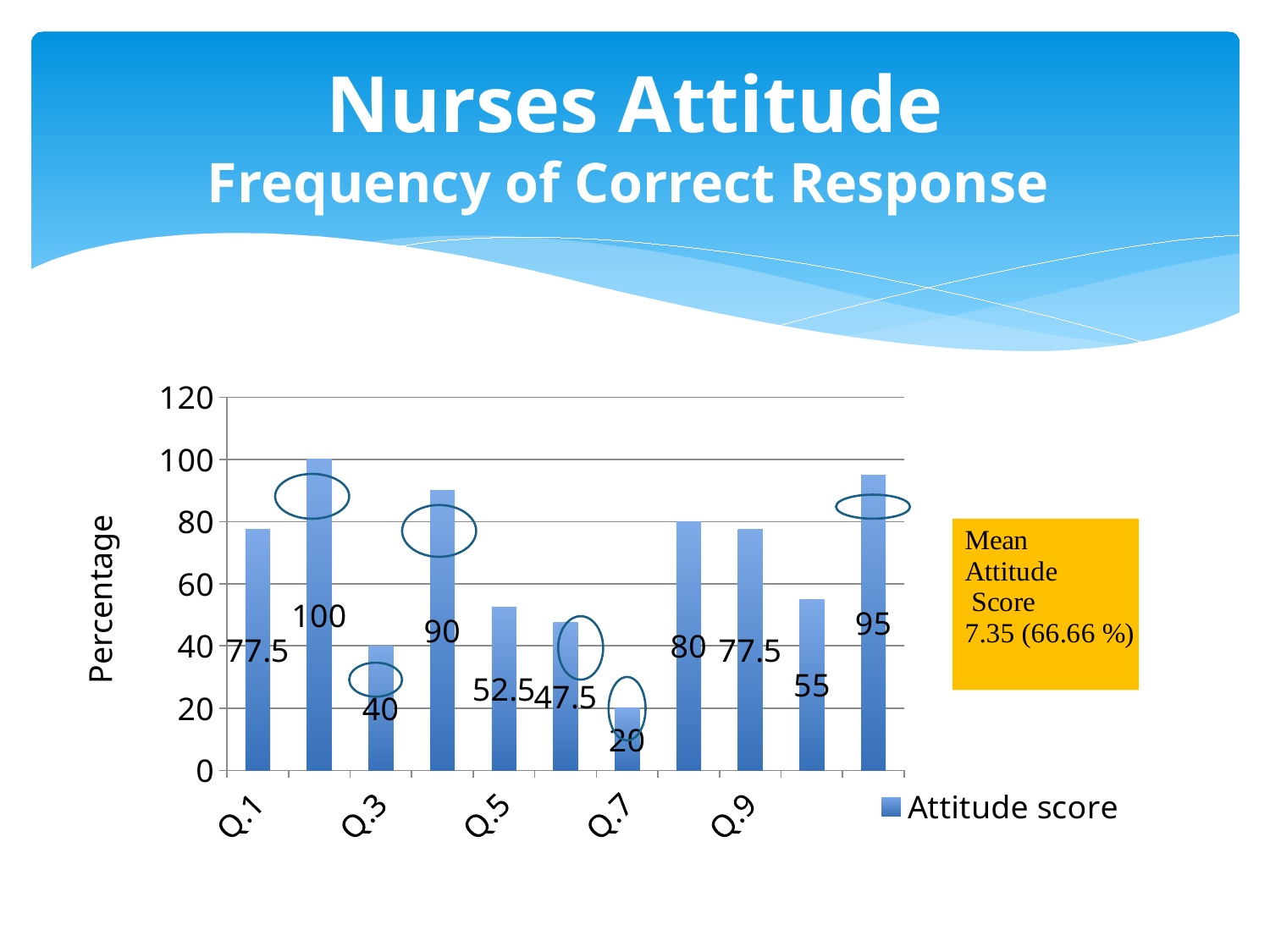
Which labelled category has the lowest value? Q.7 What is the value for Q.3? 40 What series name does the legend show? Attitude score What is the value for Q.1? 77.5 What is the highest value shown by any bar in the chart? 100 What kind of chart is shown on the slide? Bar chart What is the value for Q.5? 52.5 What is the value for Q.7? 20 What is the value for Q.9? 77.5 What is the difference between the values for Q.1 and Q.3? 37.5 Which is larger, the value for Q.5 or the value for Q.7? Q.5 How many bars are plotted in the chart? 11